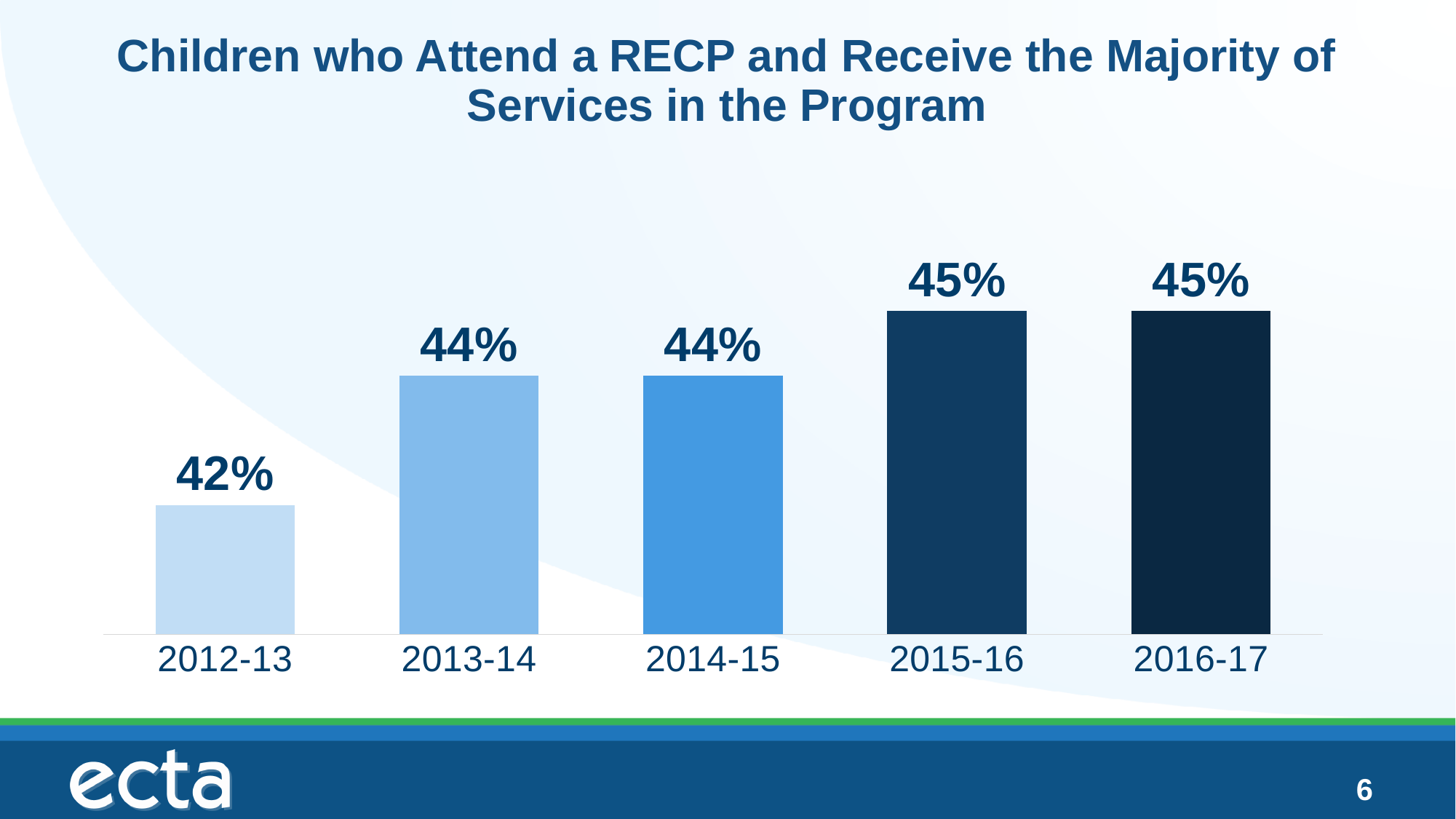
What kind of chart is shown on the slide? bar chart What is the value for 2016-17? 45% What is the difference between the values for 2013-14 and 2012-13? 2% What is the value for 2012-13? 42% Which is larger, the value for 2014-15 or the value for 2012-13? 2014-15 How many years are shown on the chart? 5 What is the value for 2015-16? 45% What is the title of the chart? Children who Attend a RECP and Receive the Majority of Services in the Program Which year has the lowest value? 2012-13 Do the values generally rise or fall from 2012-13 to 2016-17? rise What is the value for 2013-14? 44% What is the difference between the values for 2015-16 and 2012-13? 3%